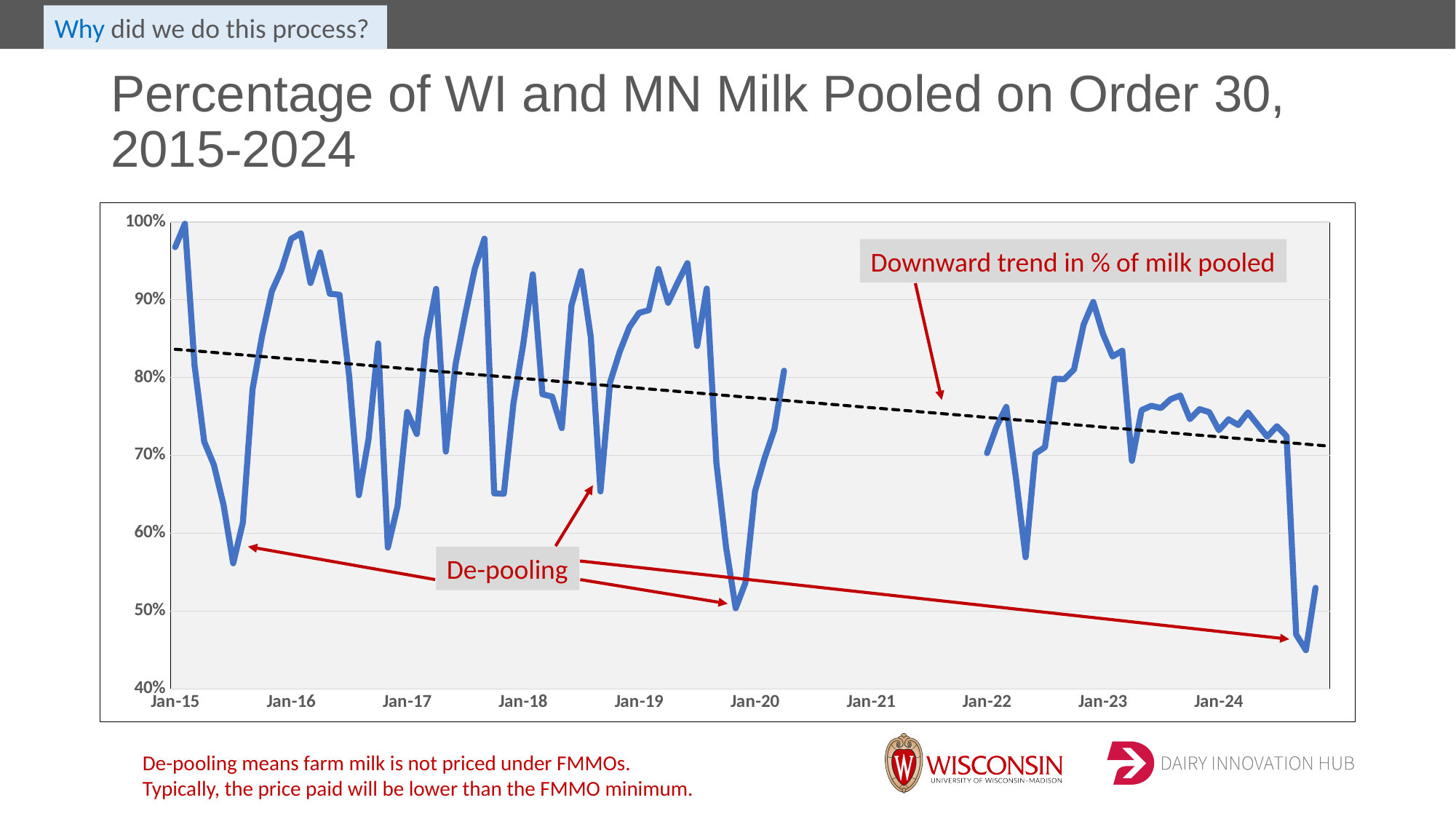
Is the value at Jan-15 higher or lower than the value at Jan-24? higher What kind of chart is shown on the slide? line chart According to the dashed trend line, do the values generally rise or fall from Jan-15 to Jan-24? fall Is the dip in the line in mid-2015 greater or less than 60%? less What label do the red arrows pointing to the sharp dips in the line carry? De-pooling Is the value at Jan-22 greater or less than 80%? less In which year does the line reach its lowest value? 2024 Is the dashed trend line at Jan-24 greater or less than 80%? less How many year labels are shown on the x axis? 10